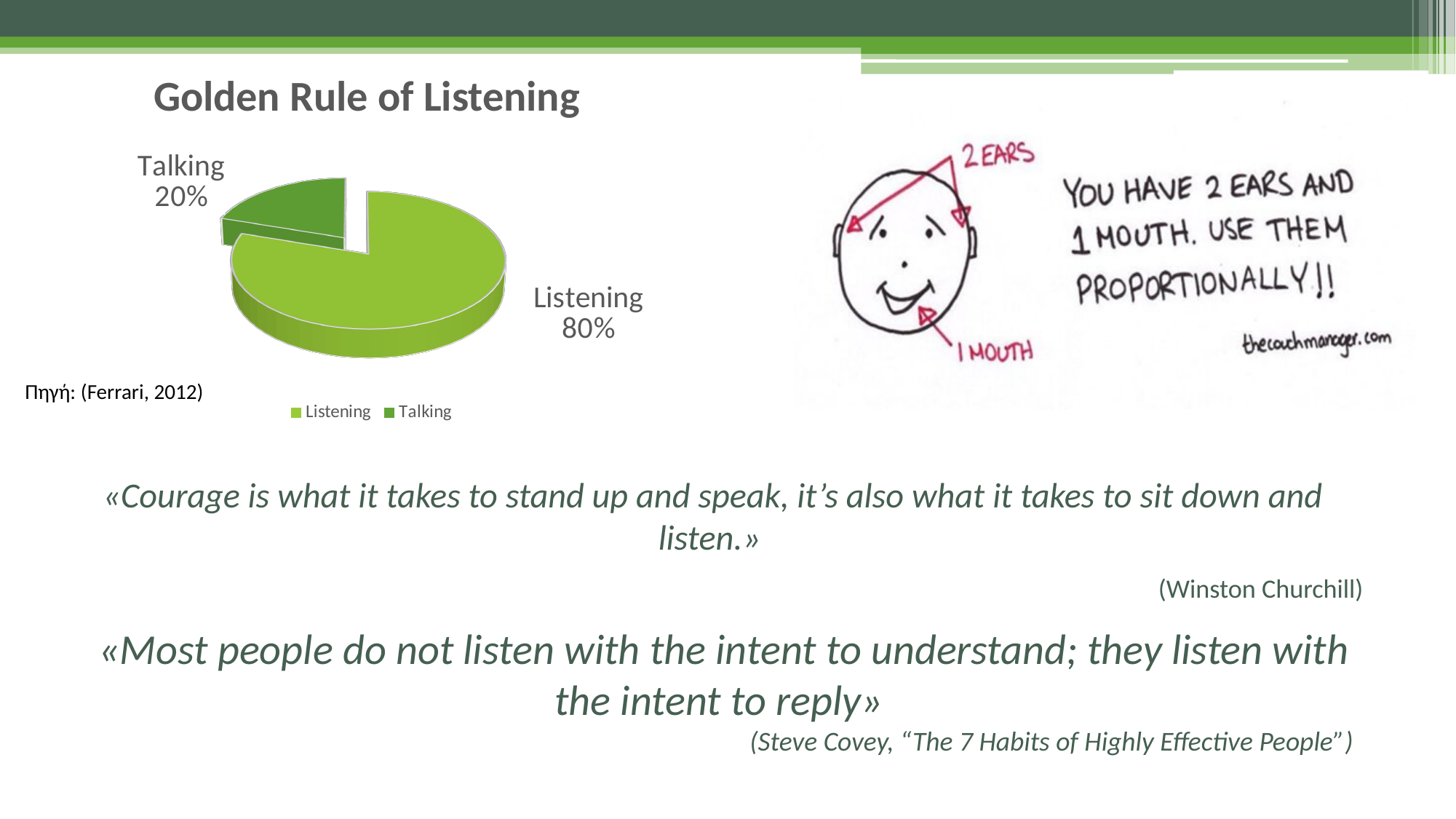
What kind of chart is shown on the slide? Pie chart Which slice of the pie is the largest? Listening How many entries does the chart legend list? 2 How many slices does the pie chart have? 2 Which legend entry is shown in the darker green colour? Talking What is the title of the chart? Golden Rule of Listening What share of the pie does Talking take? 20% What is the difference in percentage points between Listening and Talking? 60% What share of the pie does Listening take? 80% Which slice of the pie is the smallest? Talking Which is larger, the Listening slice or the Talking slice? Listening